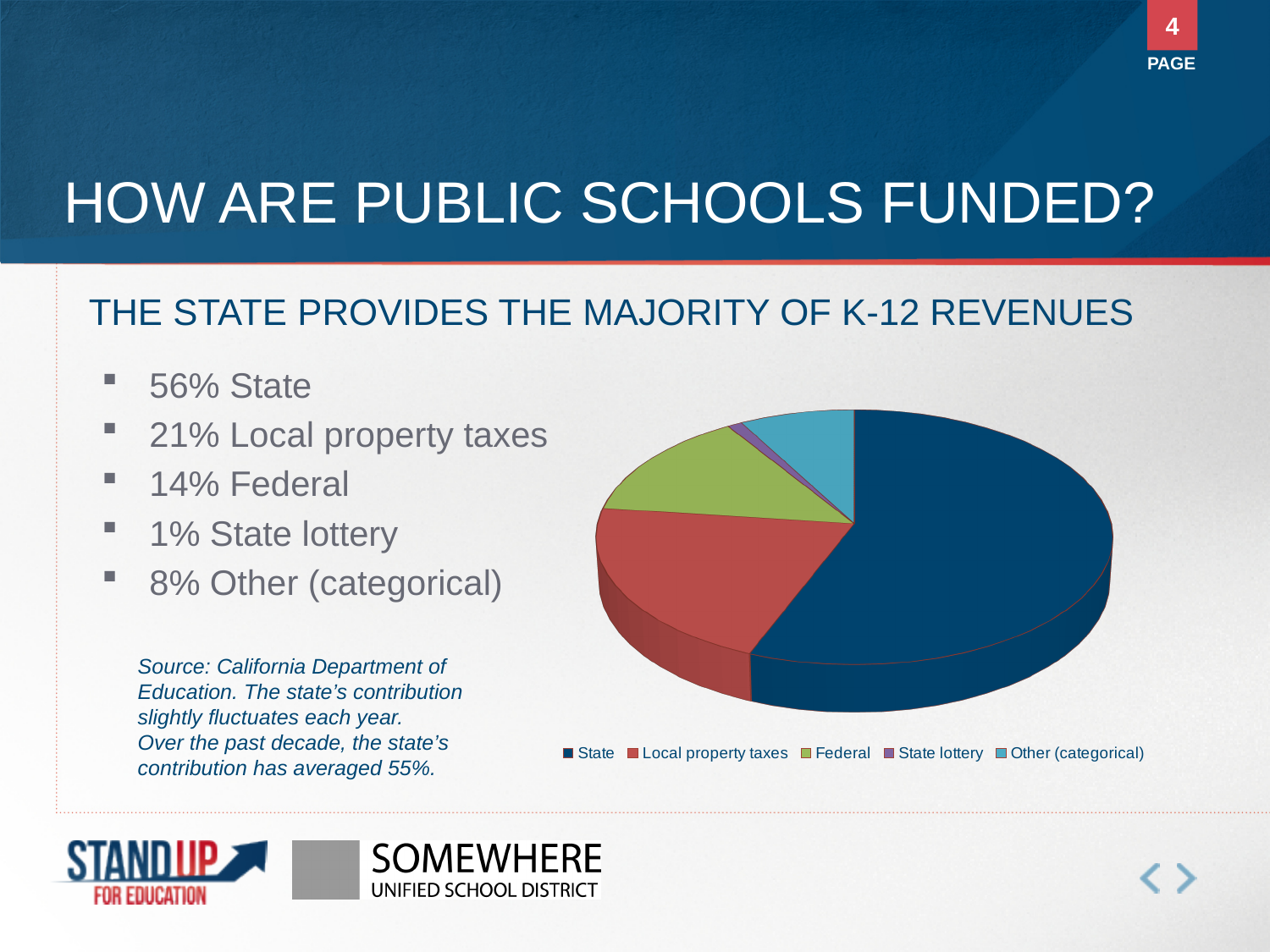
What kind of chart is shown on the slide? Pie chart How many entries does the pie chart's legend list? 5 What is the difference between the State share and the Local property taxes share shown on the slide? 35% What share of K-12 revenues comes from Local property taxes, according to the slide? 21% How many slices does the pie chart have? 5 Which funding source has the smallest slice of the pie chart? State lottery Which legend entry is shown in red in the pie chart? Local property taxes What share of K-12 revenues comes from Other (categorical), according to the slide? 8% What share of K-12 revenues comes from the State, according to the slide? 56% Which is larger in the pie chart, the Federal slice or the Other (categorical) slice? Federal Which funding source has the largest slice of the pie chart? State